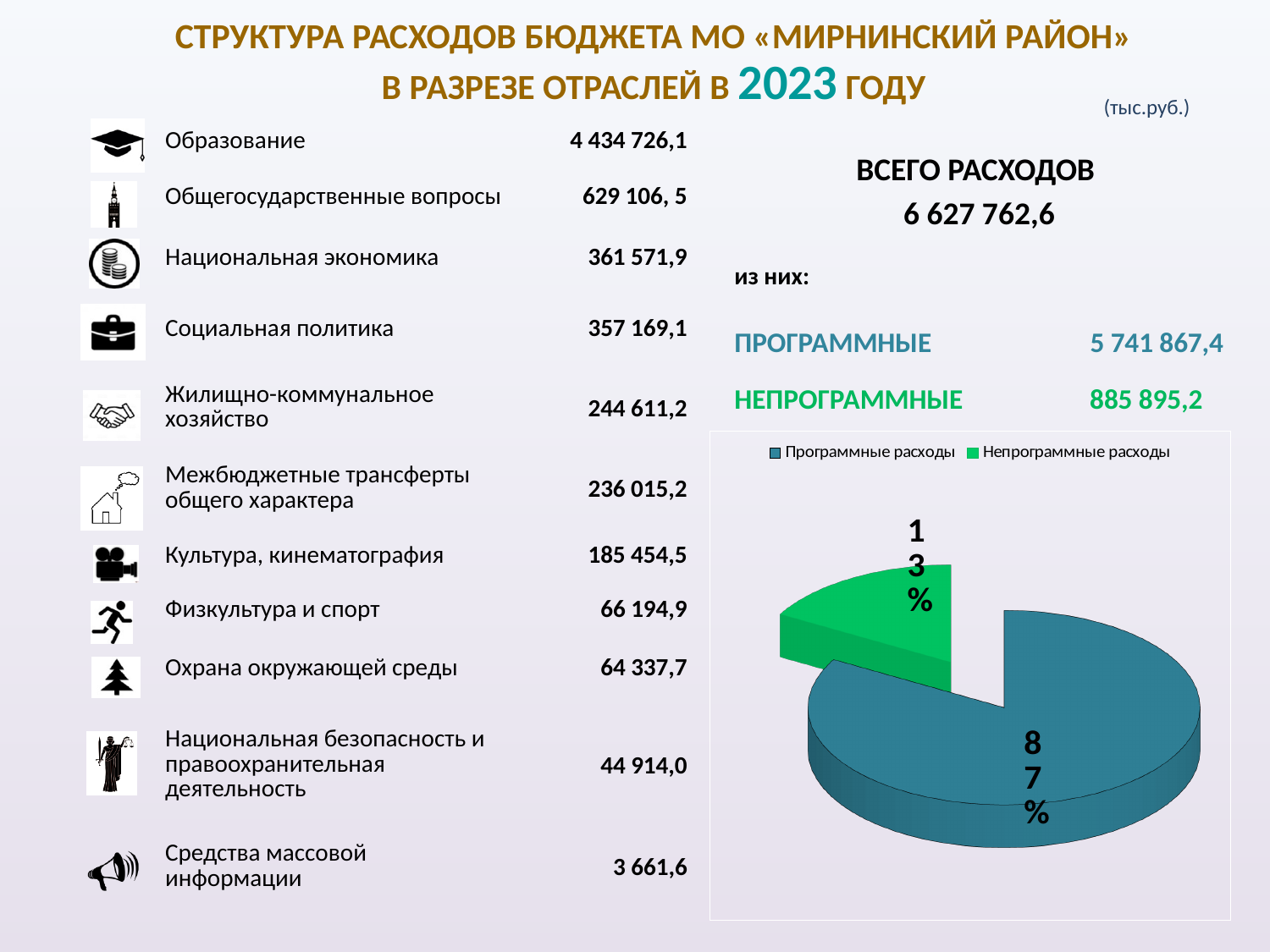
What colour is the Непрограммные расходы slice in the pie chart? green By how many percentage points does the Программные расходы share exceed the Непрограммные расходы share? 74 What colour is the Программные расходы slice in the pie chart? teal blue How many slices does the pie chart have? 2 Which slice of the pie chart is the largest? Программные расходы What kind of chart is shown on the slide? pie chart How many entries does the pie chart's legend list? 2 What share of the pie does Непрограммные расходы take? 13% Which is larger in the pie chart: Программные расходы or Непрограммные расходы? Программные расходы Which slice of the pie chart is the smallest? Непрограммные расходы What share of the pie does Программные расходы take? 87%